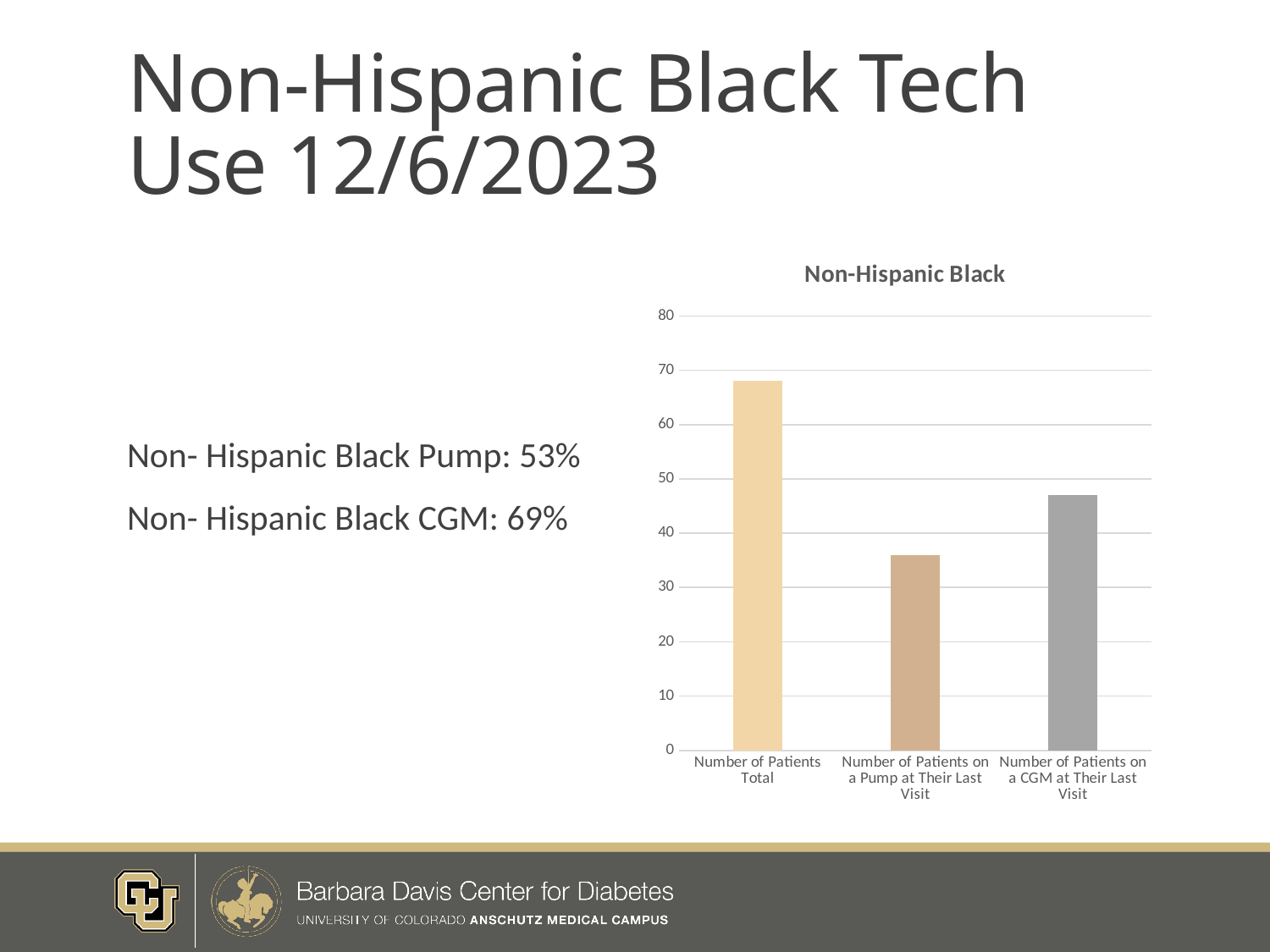
What colour is the bar for Number of Patients on a CGM at Their Last Visit? Gray Which category has the lowest bar in the chart? Number of Patients on a Pump at Their Last Visit Which is larger: the number of patients on a CGM at their last visit or the number of patients on a pump at their last visit? Number of Patients on a CGM at Their Last Visit What is the title of the chart? Non-Hispanic Black Is the value for Number of Patients Total greater or less than 70? less Is the value for Number of Patients on a CGM at Their Last Visit greater or less than 40? greater Is the value for Number of Patients on a CGM at Their Last Visit greater or less than 50? less How many categories are plotted in the chart? 3 What kind of chart is shown on the slide? Bar chart Which category has the highest bar in the chart? Number of Patients Total